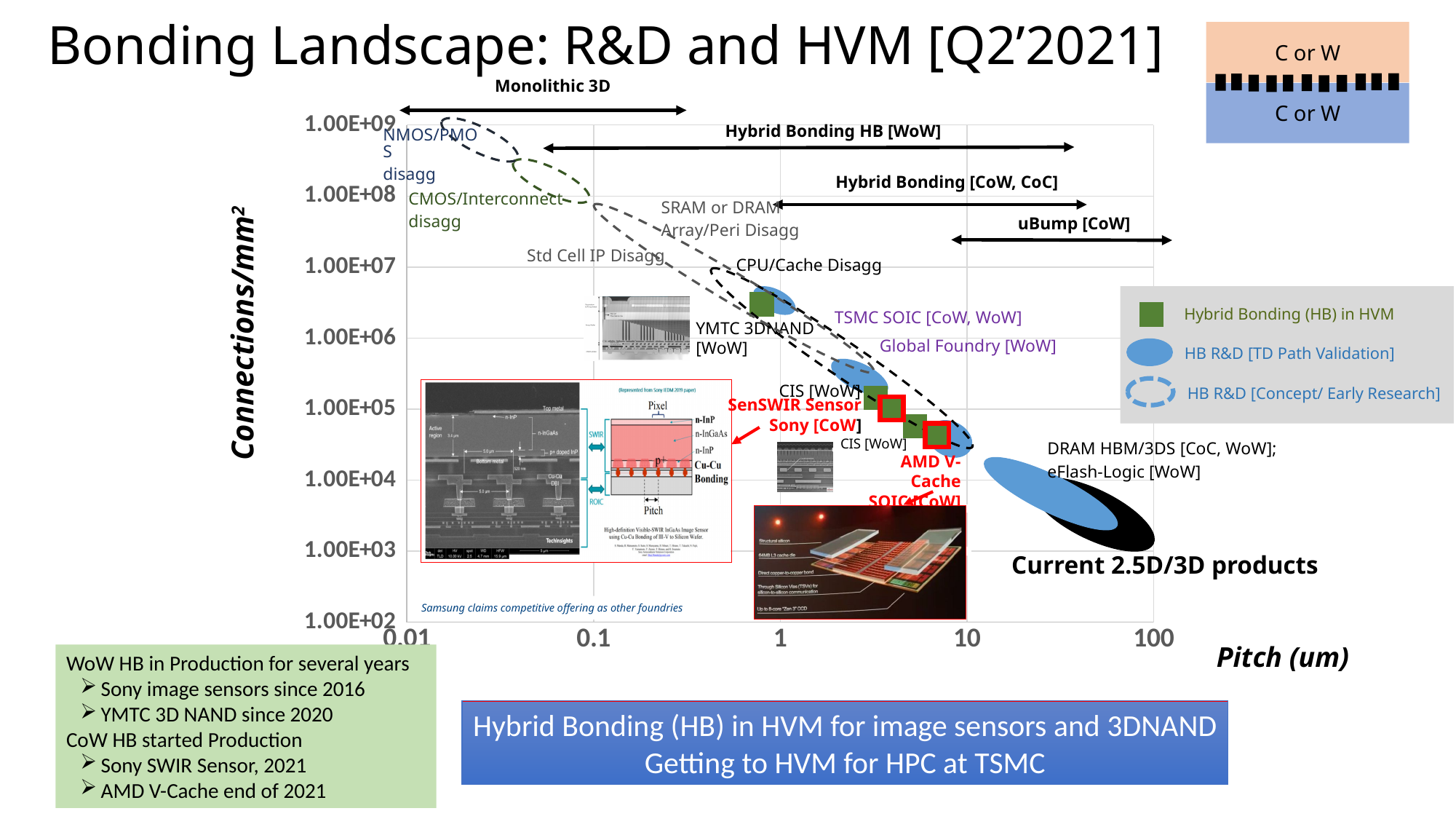
Is the pitch for YMTC 3DNAND [WoW] greater or less than 10 um? less As pitch increases along the x axis, do the Connections/mm² values rise or fall? fall What is the label of the vertical axis of the chart? Connections/mm² Is the Connections/mm² value for AMD V-Cache SOIC [CoW] greater or less than 1.00E+05? less Which has the larger pitch, YMTC 3DNAND [WoW] or AMD V-Cache SOIC [CoW]? AMD V-Cache SOIC [CoW] Is the pitch for AMD V-Cache SOIC [CoW] greater or less than 10 um? less Which has the higher Connections/mm², YMTC 3DNAND [WoW] or AMD V-Cache SOIC [CoW]? YMTC 3DNAND [WoW] What kind of chart is shown on the slide? scatter plot What is the label of the horizontal axis of the chart? Pitch (um) How many entries does the chart's legend list? 3